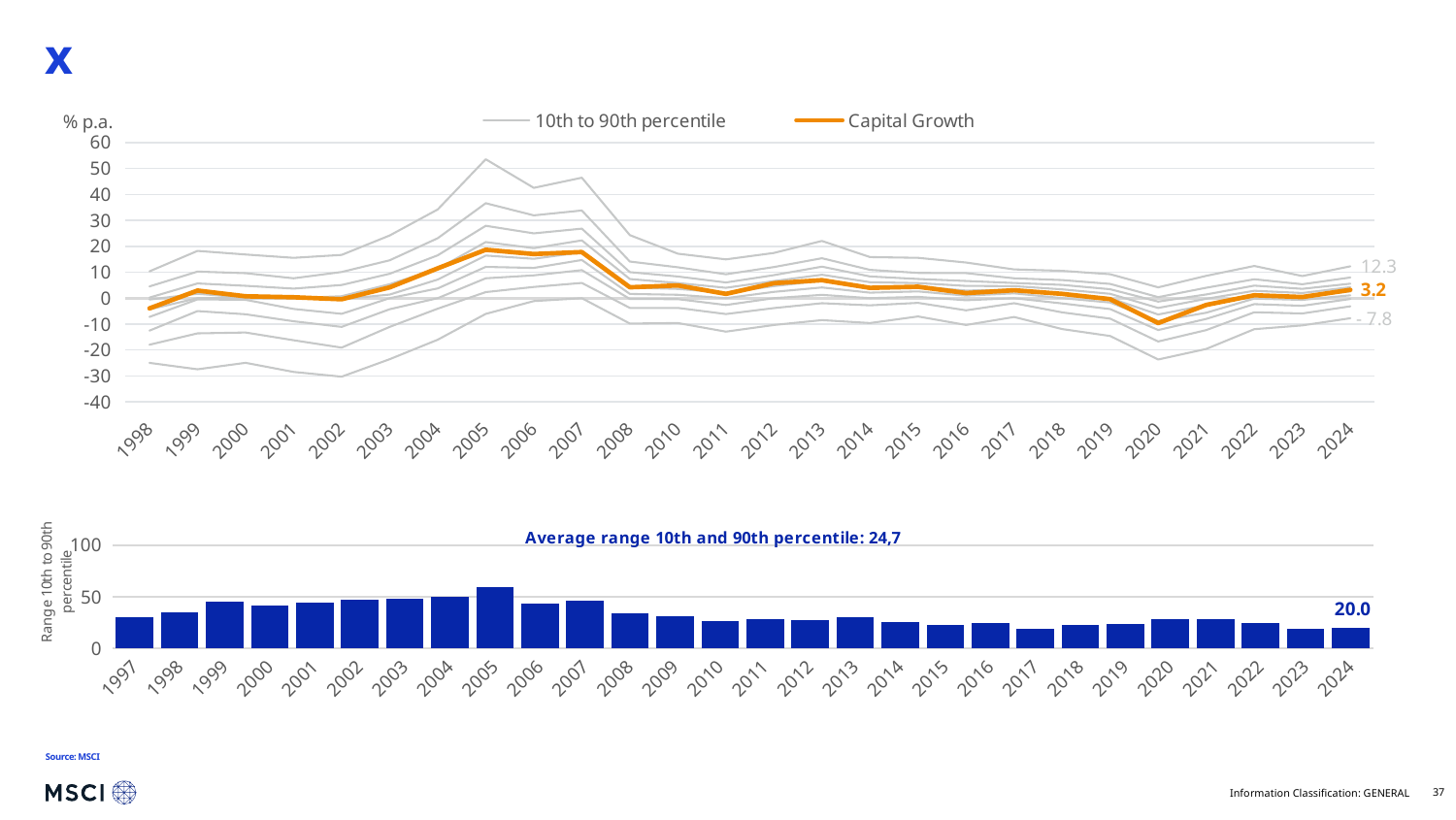
In the top line chart, is the Capital Growth value for 2020 greater or less than 0? less What kind of chart is the bottom chart on the slide? bar chart How many series does the legend of the top chart list? 2 In the top line chart, what is the lower (10th percentile) value labelled at 2024? -7.8 What kind of chart is the top chart on the slide? line chart In the top line chart, what is the upper (90th percentile) value labelled at 2024? 12.3 In the bottom bar chart, what is the value labelled for 2024? 20.0 How many bars (years) are shown in the bottom bar chart? 28 In the bottom bar chart, which year has the highest bar? 2005 In the top line chart, is the Capital Growth value for 2005 greater or less than 10? greater In the top line chart, what is the Capital Growth value labelled for 2024? 3.2 In the top line chart, in which year is the Capital Growth line at its lowest? 2020